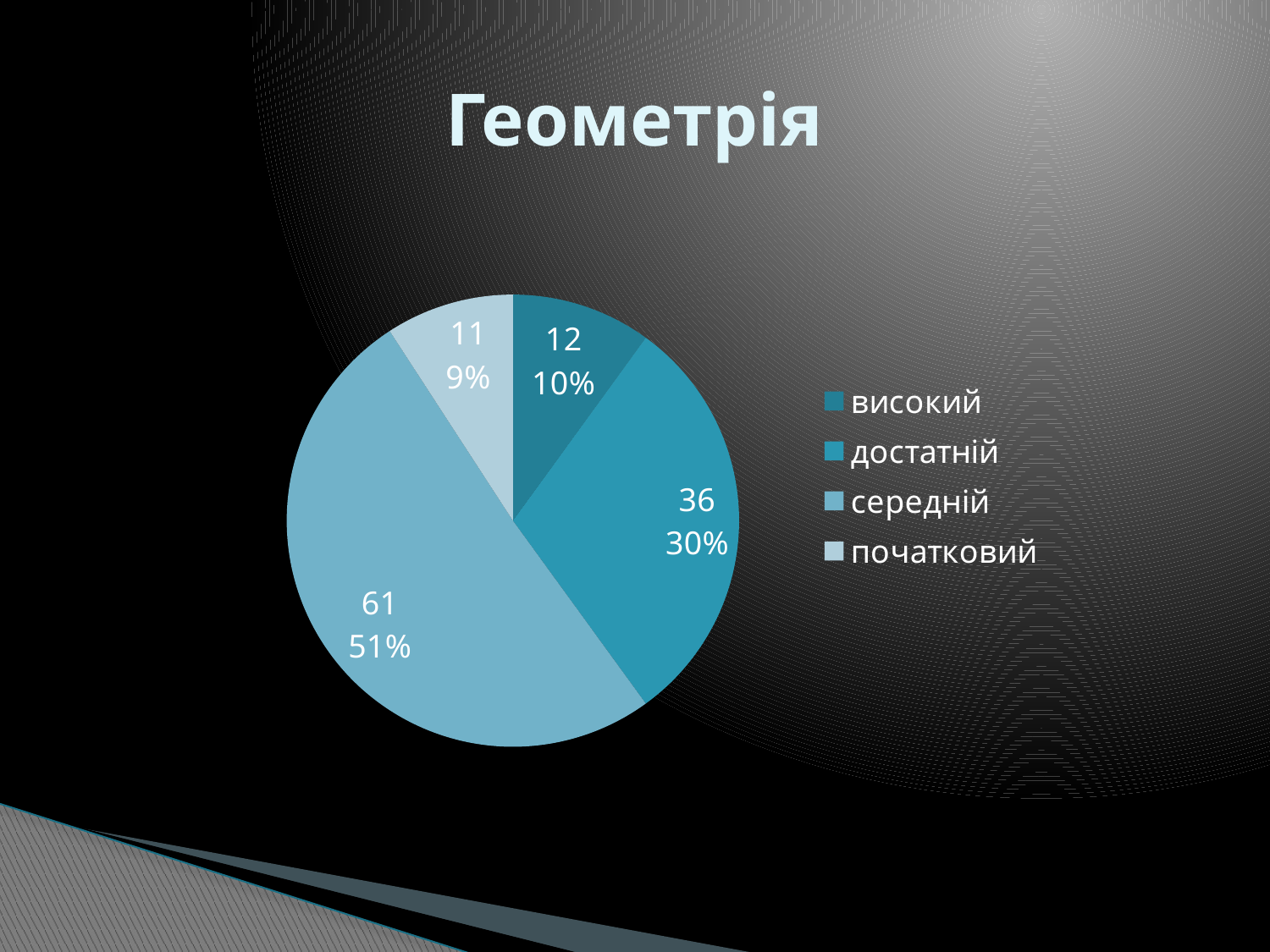
What share of the pie does достатній take? 30% Which category has the smallest slice? початковий Which category has the largest slice? середній What is the value for початковий? 11 What is the value for високий? 12 What is the difference between the values for середній and достатній? 25 Which is larger, the value for високий or the value for початковий? високий What kind of chart is shown on the slide? pie chart What is the value for достатній? 36 What share of the pie does середній take? 51% How many categories does the legend list? 4 What is the value for середній? 61